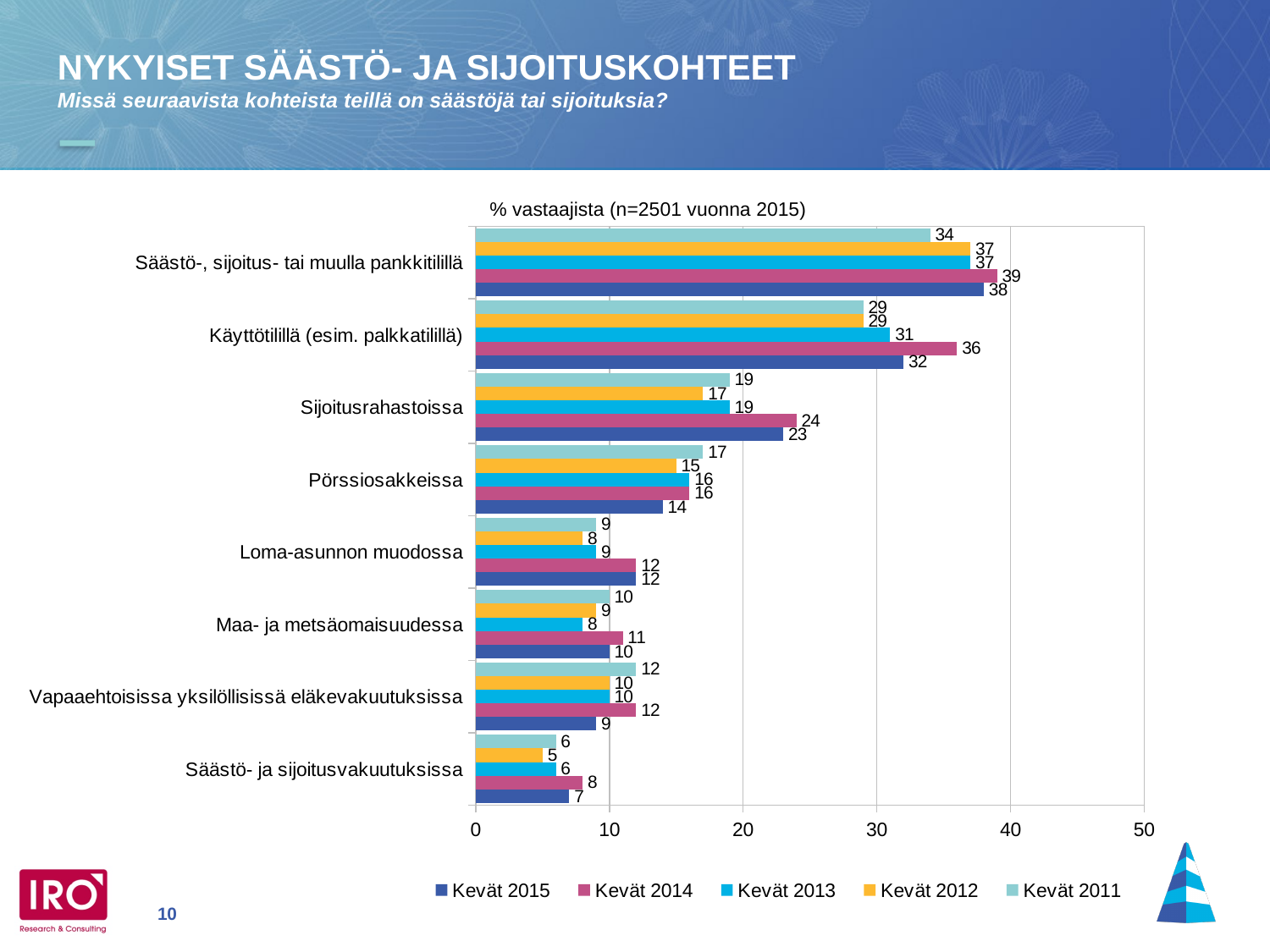
What is the value for Kevät 2011 in the category "Pörssiosakkeissa"? 17 What is the difference between the Kevät 2014 and Kevät 2015 values for "Käyttötilillä (esim. palkkatilillä)"? 4 What is the value for Kevät 2015 in the category "Säästö-, sijoitus- tai muulla pankkitilillä"? 38 What is the value for Kevät 2012 in the category "Sijoitusrahastoissa"? 17 How many series does the legend list? 5 What is the value for Kevät 2014 in the category "Käyttötilillä (esim. palkkatilillä)"? 36 Which category has the lowest value for Kevät 2014? Säästö- ja sijoitusvakuutuksissa What is the title printed above the chart? % vastaajista (n=2501 vuonna 2015) Which is larger for "Sijoitusrahastoissa": the Kevät 2014 value or the Kevät 2012 value? Kevät 2014 What kind of chart is shown on the slide? Bar chart How many categories are shown on the chart? 8 Which category has the highest value for Kevät 2015? Säästö-, sijoitus- tai muulla pankkitilillä